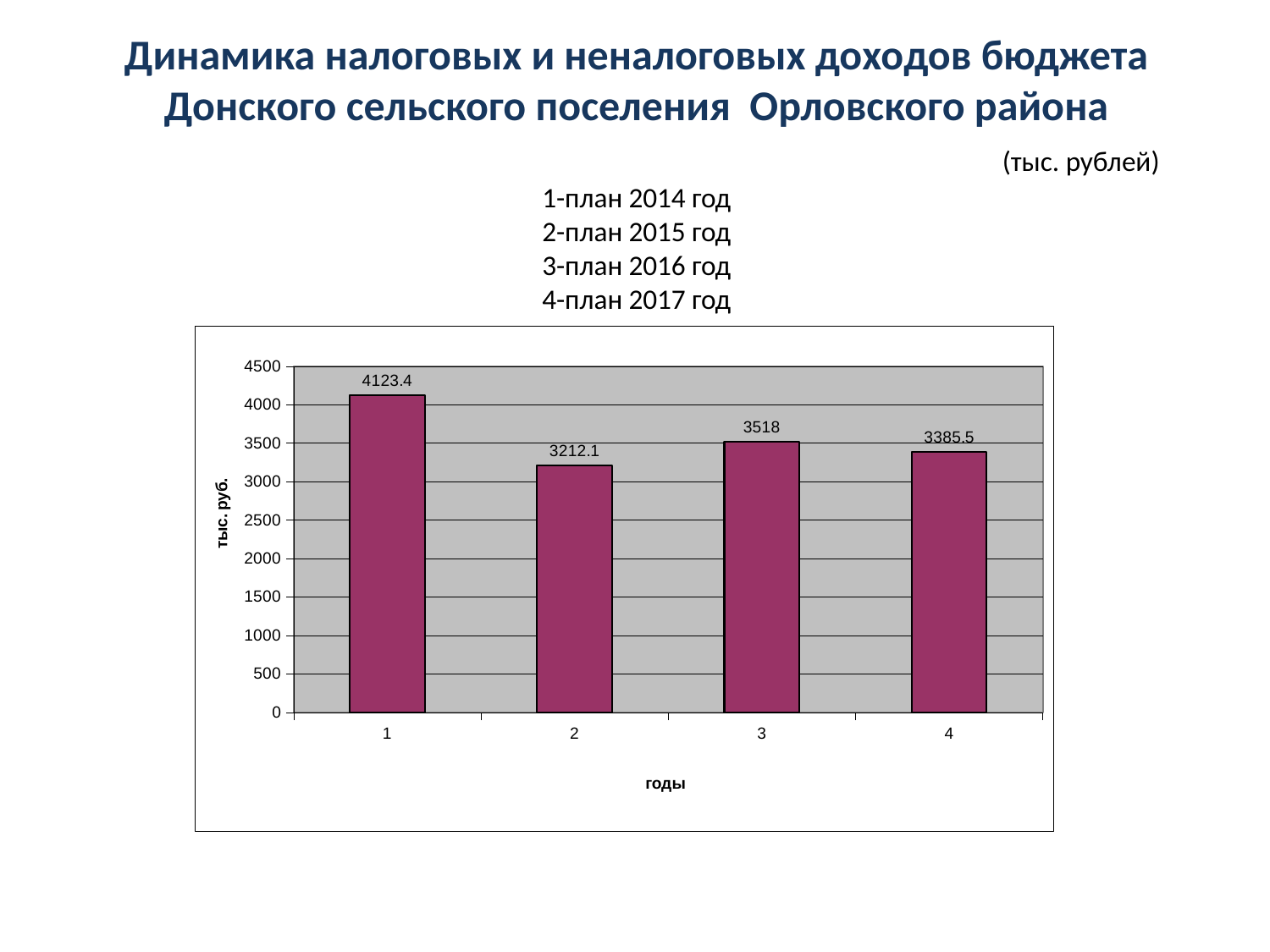
Which category has the highest value? 1 What is the difference between the values for category 3 and category 4? 132.5 What is the difference between the values for category 1 and category 2? 911.3 What is the value for category 3 (план 2016 год)? 3518 What is the value for category 2 (план 2015 год)? 3212.1 What is the label of the vertical axis? тыс. руб. What kind of chart is shown on the slide? bar chart What is the value for category 1 (план 2014 год)? 4123.4 Which is larger, the value for category 3 or the value for category 4? 3 Which category has the lowest value? 2 What is the value for category 4 (план 2017 год)? 3385.5 How many bars are shown in the chart? 4